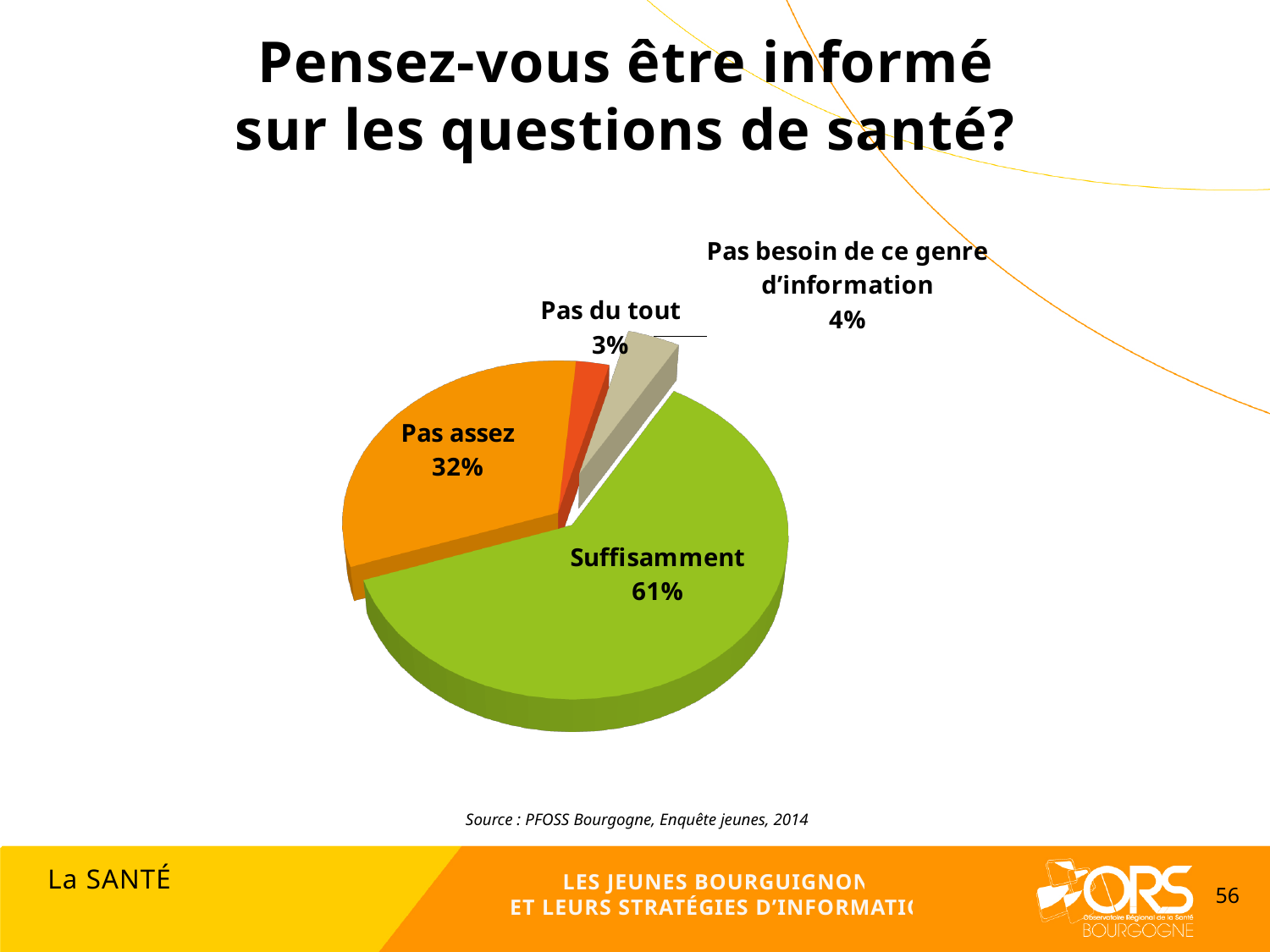
What is the difference in percentage points between "Suffisamment" and "Pas assez"? 29 What is the combined percentage of "Pas du tout" and "Pas besoin de ce genre d'information"? 7% How many slices does the pie chart have? 4 What percentage of respondents answered "Suffisamment"? 61% Which response has the smallest share of the pie? Pas du tout What colour is the "Suffisamment" slice? Green Which response has the largest share of the pie? Suffisamment What type of chart is shown on the slide? Pie chart Which is larger: the share for "Pas besoin de ce genre d'information" or the share for "Pas du tout"? Pas besoin de ce genre d'information What percentage of respondents answered "Pas besoin de ce genre d'information"? 4% What percentage of respondents answered "Pas du tout"? 3% What percentage of respondents answered "Pas assez"? 32%